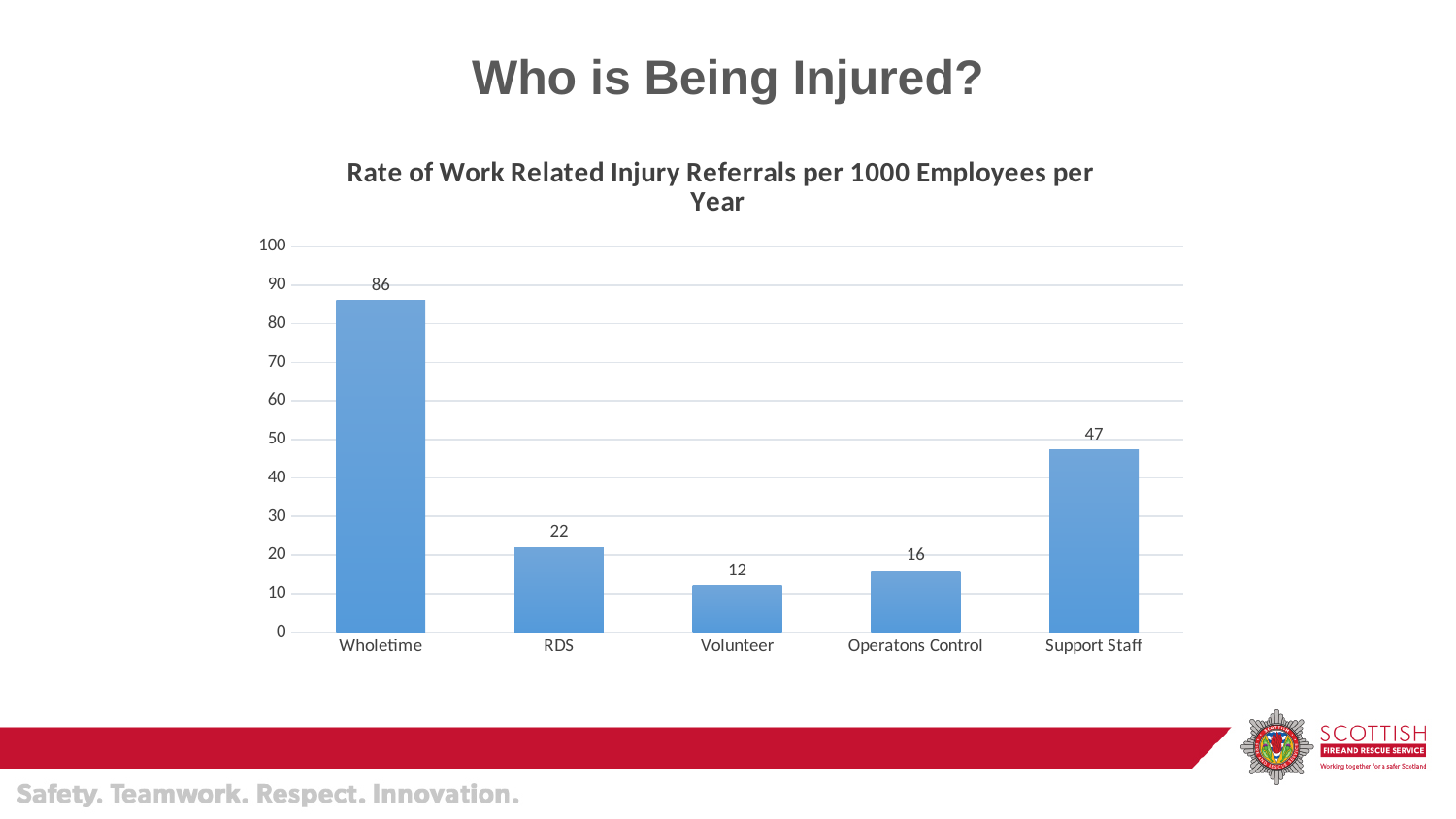
What is the value shown for Volunteer? 12 Which is larger, the value for RDS or the value for Operatons Control? RDS What is the difference between the values for Wholetime and Support Staff? 39 What is the title of the chart? Rate of Work Related Injury Referrals per 1000 Employees per Year How many categories are shown on the x axis? 5 What kind of chart is shown on the slide? Bar chart What is the value shown for Support Staff? 47 Is the value for Support Staff greater or less than 50? less What is the difference between the values for RDS and Operatons Control? 6 Which category has the lowest rate of injury referrals? Volunteer What is the rate of work related injury referrals per 1000 employees for Wholetime? 86 Which category has the highest rate of injury referrals? Wholetime